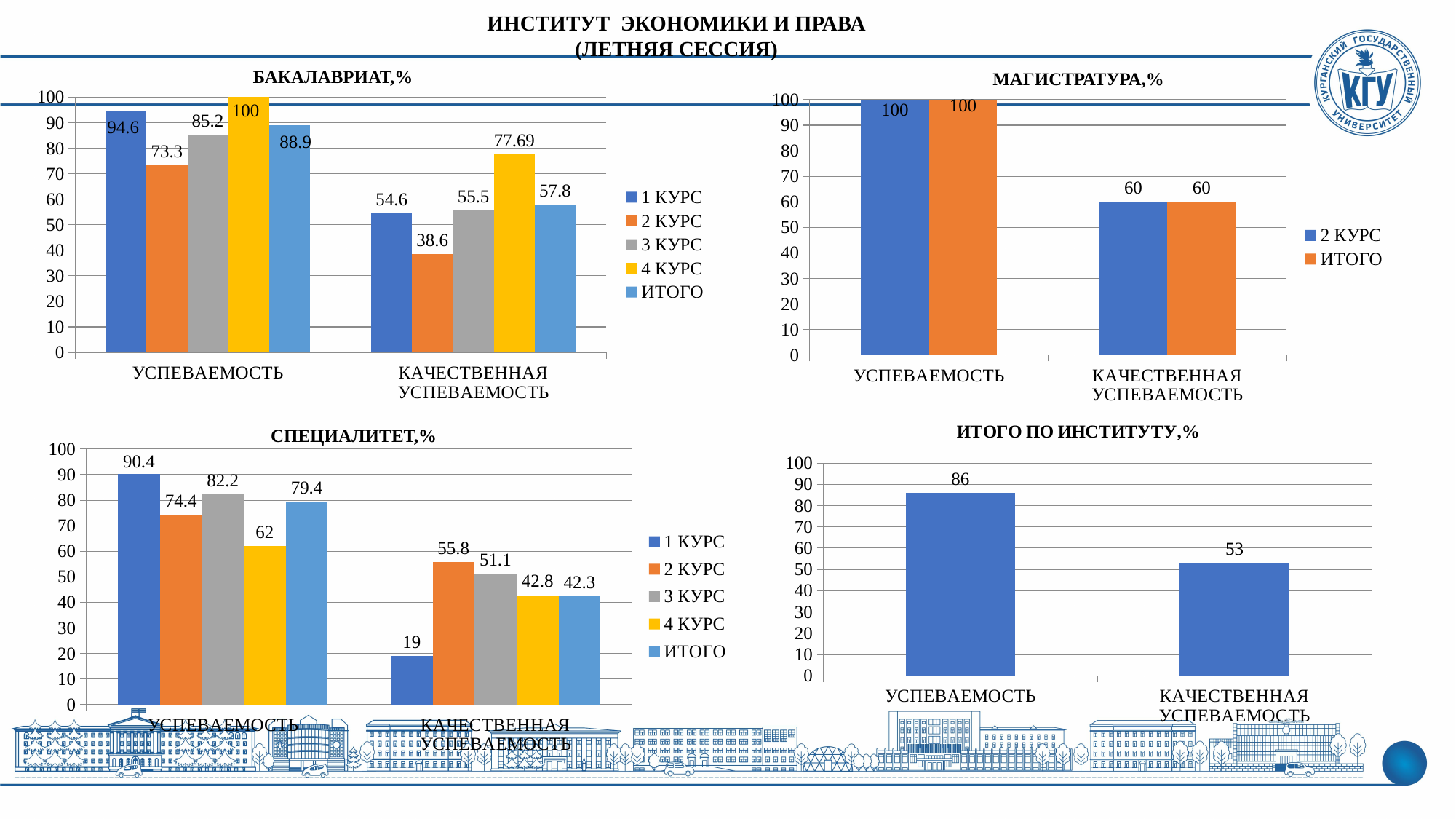
In the СПЕЦИАЛИТЕТ,% chart, what is the value for 1 КУРС in the КАЧЕСТВЕННАЯ УСПЕВАЕМОСТЬ category? 19 In the МАГИСТРАТУРА,% chart, what is the value for 2 КУРС in the КАЧЕСТВЕННАЯ УСПЕВАЕМОСТЬ category? 60 In the БАКАЛАВРИАТ,% chart, what is the value for 4 КУРС in the КАЧЕСТВЕННАЯ УСПЕВАЕМОСТЬ category? 77.69 In the БАКАЛАВРИАТ,% chart, what is the difference between the ИТОГО values for УСПЕВАЕМОСТЬ and КАЧЕСТВЕННАЯ УСПЕВАЕМОСТЬ? 31.1 What kind of chart is the ИТОГО ПО ИНСТИТУТУ,% chart? Bar chart In the СПЕЦИАЛИТЕТ,% chart, which series has the highest value in the УСПЕВАЕМОСТЬ category? 1 КУРС In the ИТОГО ПО ИНСТИТУТУ,% chart, what is the value for КАЧЕСТВЕННАЯ УСПЕВАЕМОСТЬ? 53 How many series does the legend of the БАКАЛАВРИАТ,% chart list? 5 In the БАКАЛАВРИАТ,% chart, which series has the lowest value in the КАЧЕСТВЕННАЯ УСПЕВАЕМОСТЬ category? 2 КУРС In the БАКАЛАВРИАТ,% chart, what is the value for 1 КУРС in the УСПЕВАЕМОСТЬ category? 94.6 In the СПЕЦИАЛИТЕТ,% chart, which is larger in the КАЧЕСТВЕННАЯ УСПЕВАЕМОСТЬ category: 2 КУРС or 3 КУРС? 2 КУРС How many series does the legend of the МАГИСТРАТУРА,% chart list? 2